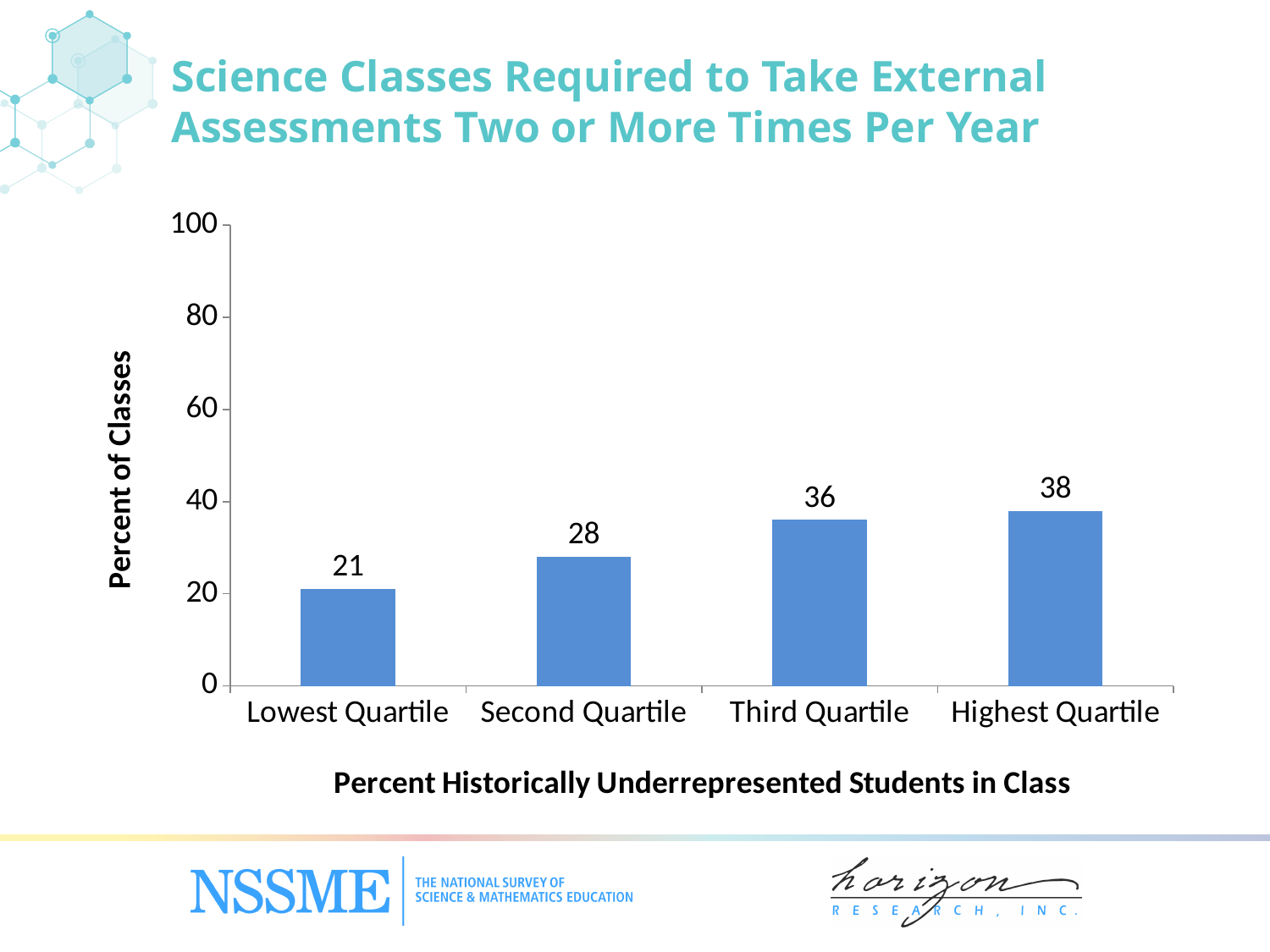
Do the values rise or fall from Lowest Quartile to Highest Quartile? rise How many categories are shown on the x axis? 4 What is the difference between the values for Highest Quartile and Lowest Quartile? 17 What kind of chart is shown on the slide? bar chart Is the value for Third Quartile greater or less than 40? less Which is larger, the value for Second Quartile or the value for Third Quartile? Third Quartile What is the value for Second Quartile? 28 What is the value for Highest Quartile? 38 Which quartile has the lowest percent of classes? Lowest Quartile Which quartile has the highest percent of classes? Highest Quartile What is the value for Lowest Quartile? 21 What is the value for Third Quartile? 36